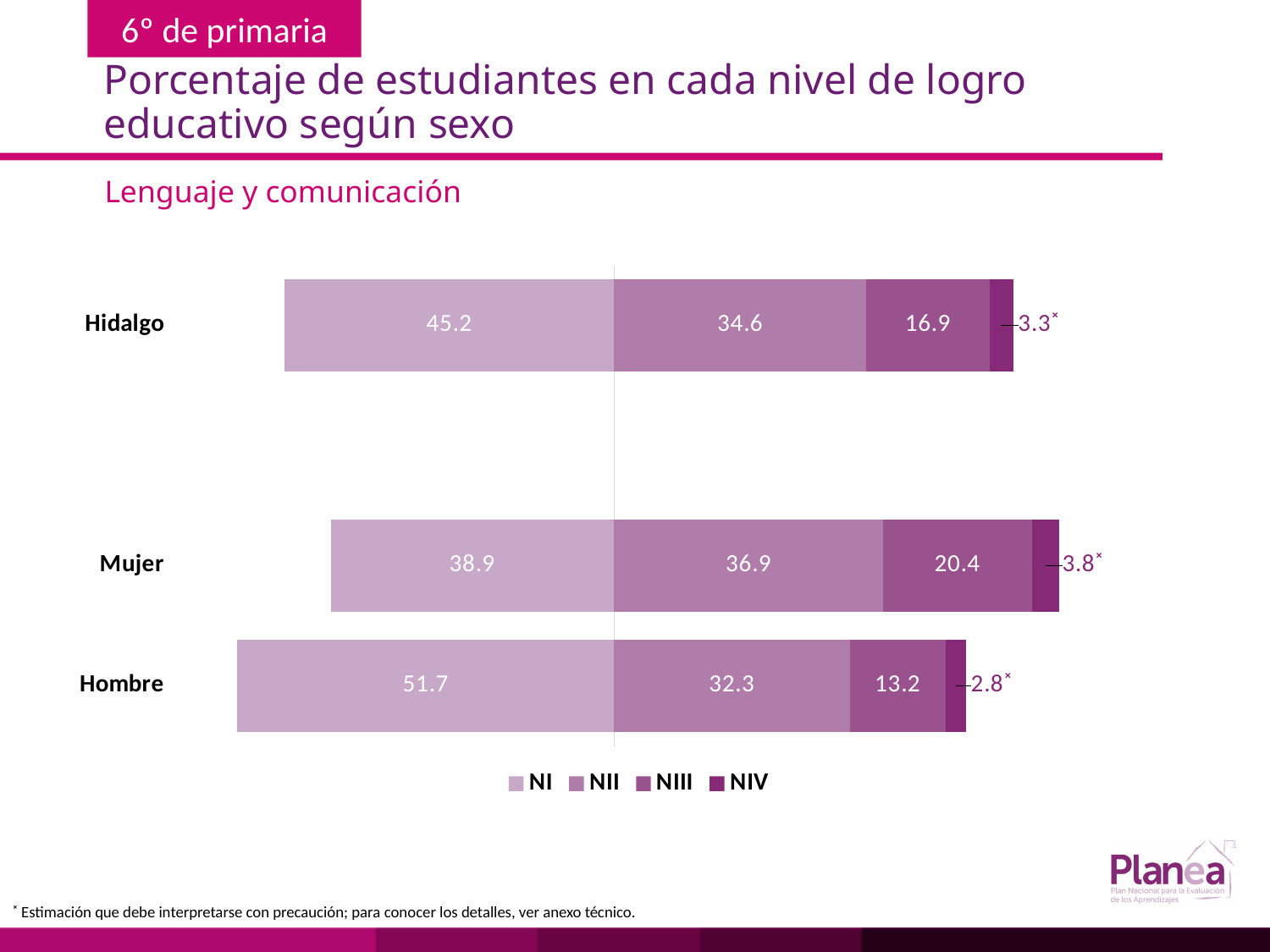
Which category has the highest NI value? Hombre What is the difference between the NI values for Hombre and Mujer? 12.8 What is the NII value for Hidalgo? 34.6 Which is larger, the NII value for Mujer or the NII value for Hidalgo? Mujer What is the value for NIII for Mujer? 20.4 What is the total of the stacked bar for Mujer? 100.0 What is the NIV value for Hombre? 2.8 Which category has the lowest NIII value? Hombre How many categories are shown on the chart? 3 How many series does the legend list? 4 What kind of chart is shown on the slide? Stacked bar chart What percentage of Hombre students are at level NI? 51.7